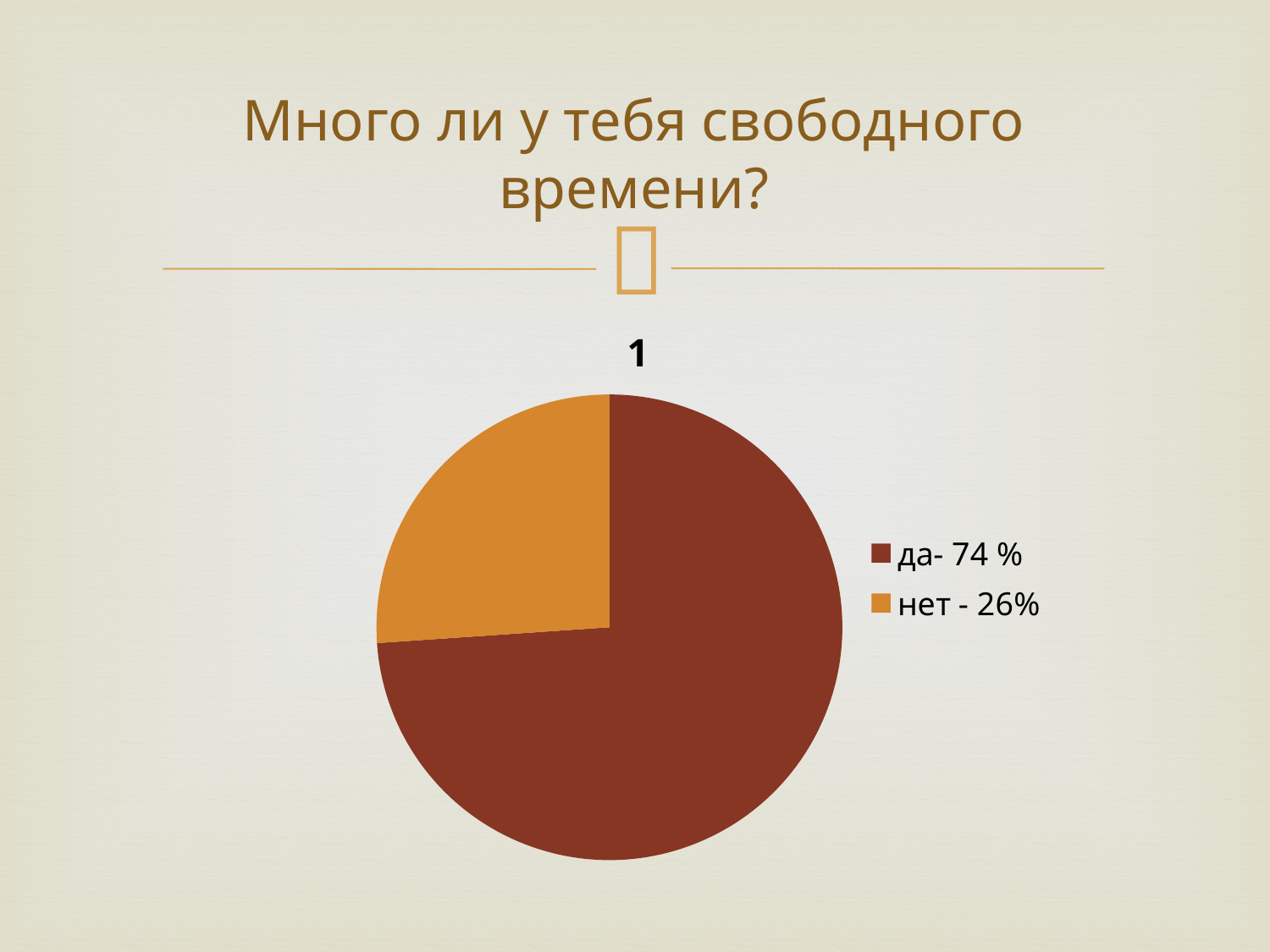
How many entries does the legend of the pie chart list? 2 Which slice of the pie chart is the smallest? нет How many slices does the pie chart have? 2 What share of the pie does the "да" slice represent? 74 % What is the title shown above the pie chart? 1 Which is larger, the "да" slice or the "нет" slice? да What kind of chart is shown on the slide? pie chart What share of the pie does the "нет" slice represent? 26% By how many percentage points does the "да" share exceed the "нет" share? 48 Which slice of the pie chart is the largest? да What colour is the "нет" slice in the pie chart? orange